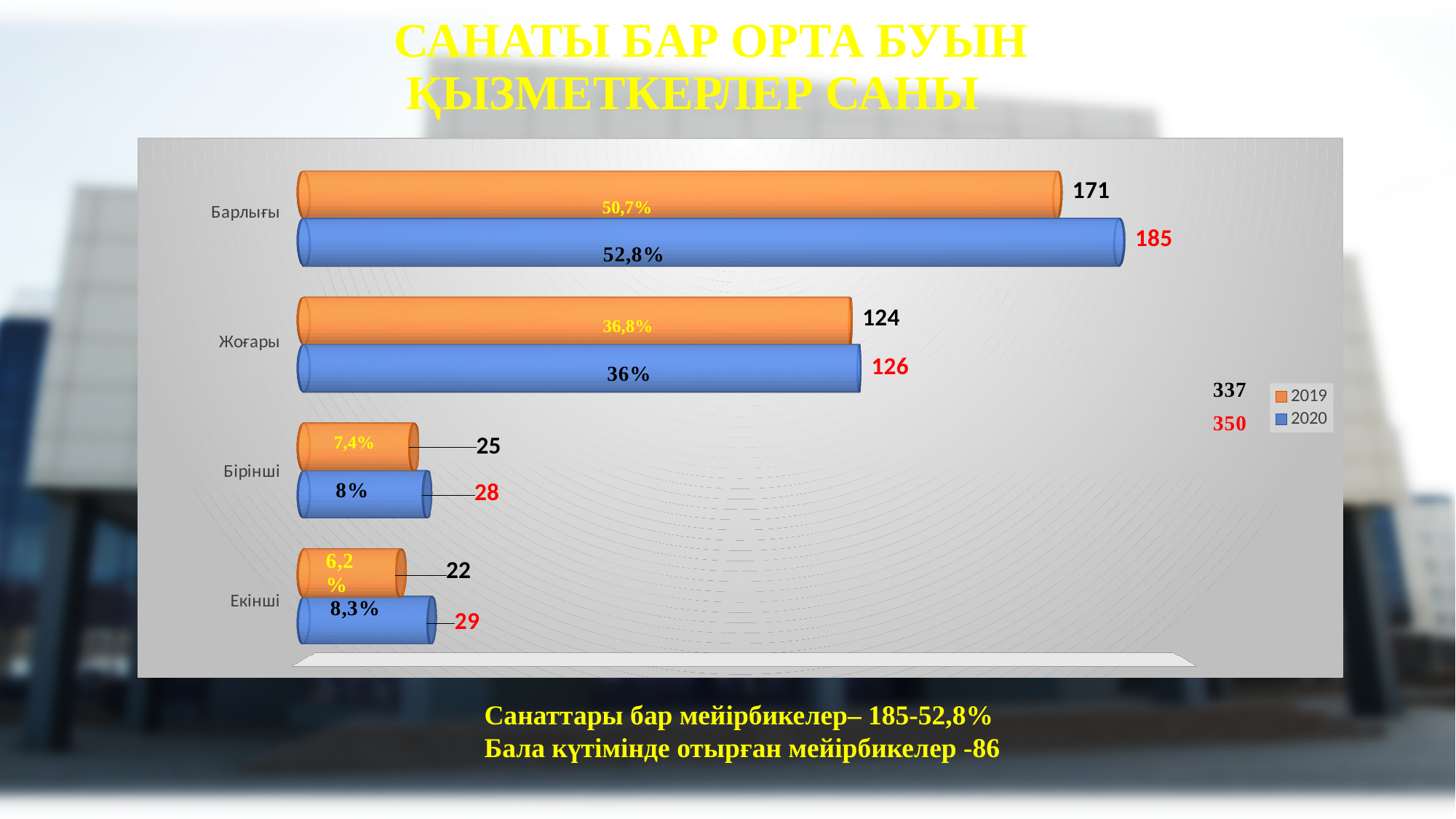
Which is larger for Бірінші, the 2019 value or the 2020 value? 2020 Which category has the lowest 2019 value? Екінші What is the difference between the 2020 and 2019 values for Екінші? 7 How many categories are shown on the chart? 4 What is the 2020 value for Екінші? 29 What is the 2020 value for Жоғары? 126 What is the 2019 value for Барлығы? 171 What kind of chart is shown on the slide? Bar chart What percentage is printed inside the 2020 bar for Барлығы? 52,8% How many series does the legend list? 2 What is the difference between the 2020 and 2019 values for Барлығы? 14 Which category has the highest 2020 value? Барлығы